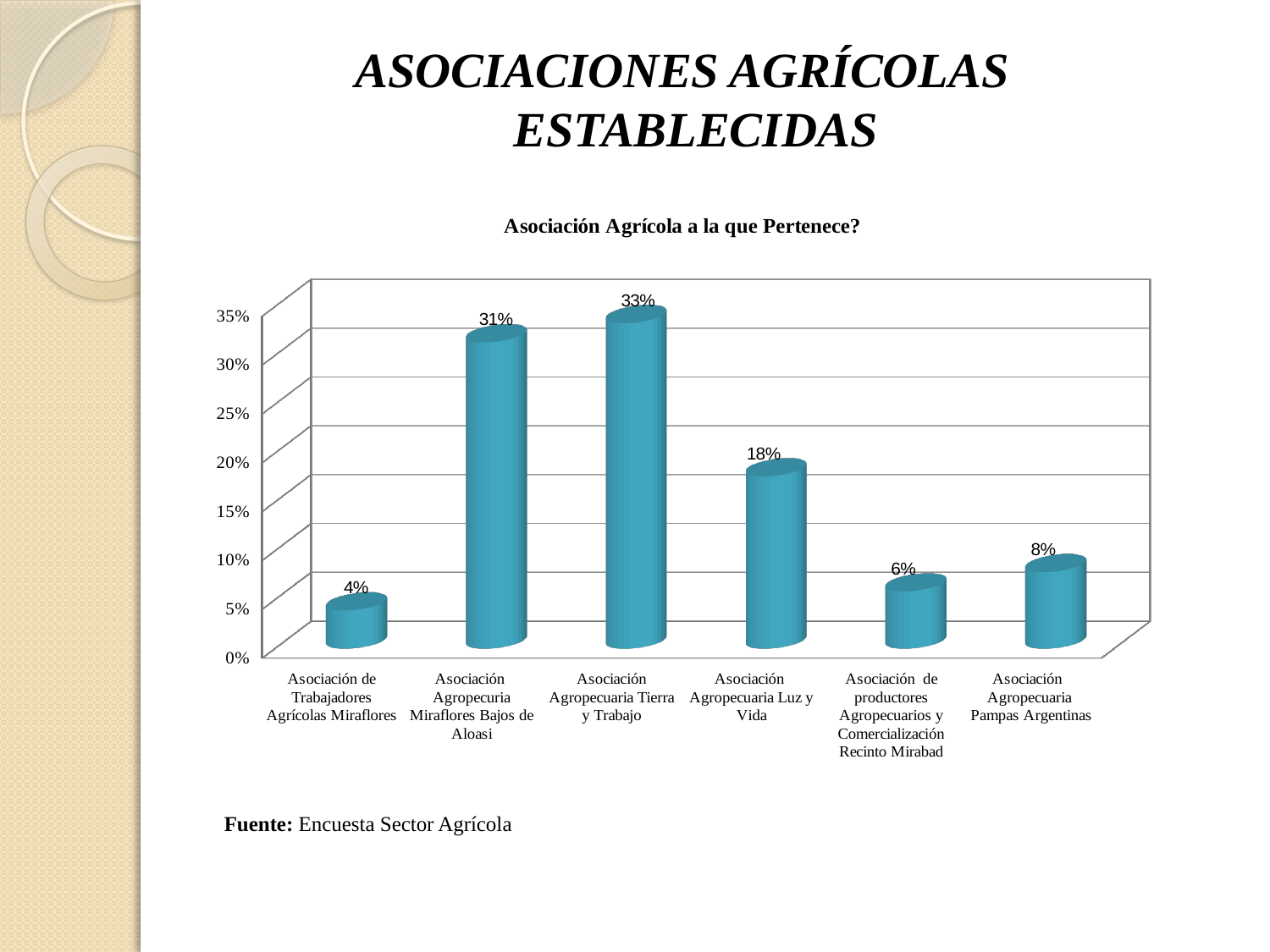
What is the title of the chart? Asociación Agrícola a la que Pertenece? What kind of chart is shown on the slide? Bar chart What is the difference between the values for Asociación Agropecuaria Tierra y Trabajo and Asociación Agropecuaria Luz y Vida? 15% Which is larger: the value for Asociación Agropecuaria Pampas Argentinas or the value for Asociación de productores Agropecuarios y Comercialización Recinto Mirabad? Asociación Agropecuaria Pampas Argentinas What is the value for Asociación Agropecuaria Tierra y Trabajo? 33% What is the value for Asociación Agropecuaria Luz y Vida? 18% Which category has the highest value? Asociación Agropecuaria Tierra y Trabajo How many categories are shown on the x axis? 6 What is the value for Asociación Agropecuaria Pampas Argentinas? 8% What is the value for Asociación de Trabajadores Agrícolas Miraflores? 4% What source is cited below the chart? Encuesta Sector Agrícola Which category has the lowest value? Asociación de Trabajadores Agrícolas Miraflores